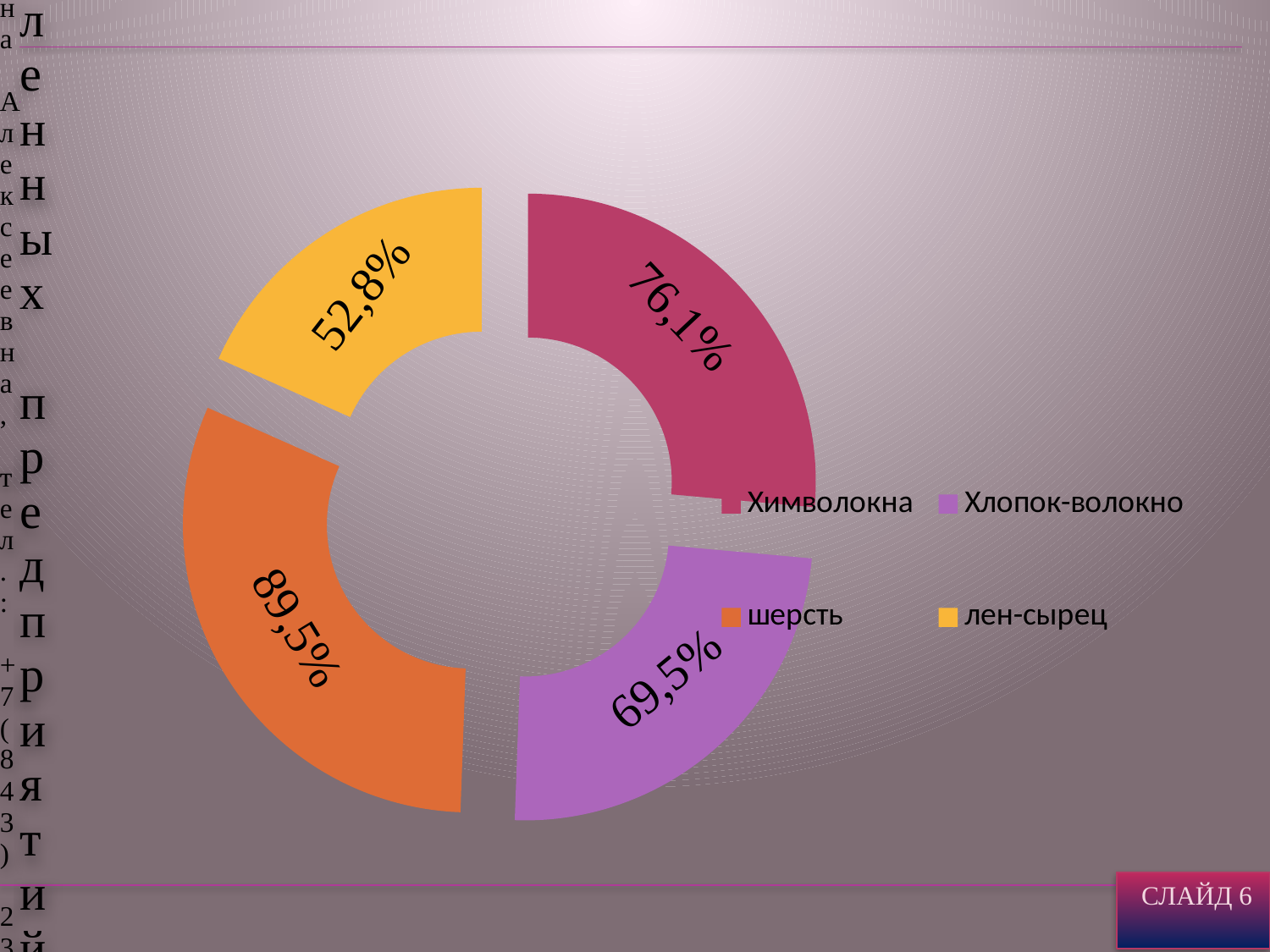
Which category has the highest value on the chart? шерсть Which category has the lowest value on the chart? лен-сырец How many categories are shown on the chart? 4 What value is shown for шерсть on the chart? 89,5% What kind of chart is shown on the slide? Doughnut (ring) chart Which colour represents лен-сырец in the legend? Yellow What is the difference between the values for шерсть and лен-сырец? 36,7% What value is shown for Химволокна on the chart? 76,1% What value is shown for лен-сырец on the chart? 52,8% Which has a larger value, Химволокна or Хлопок-волокно? Химволокна What value is shown for Хлопок-волокно on the chart? 69,5% What is the difference between the values for Химволокна and Хлопок-волокно? 6,6%